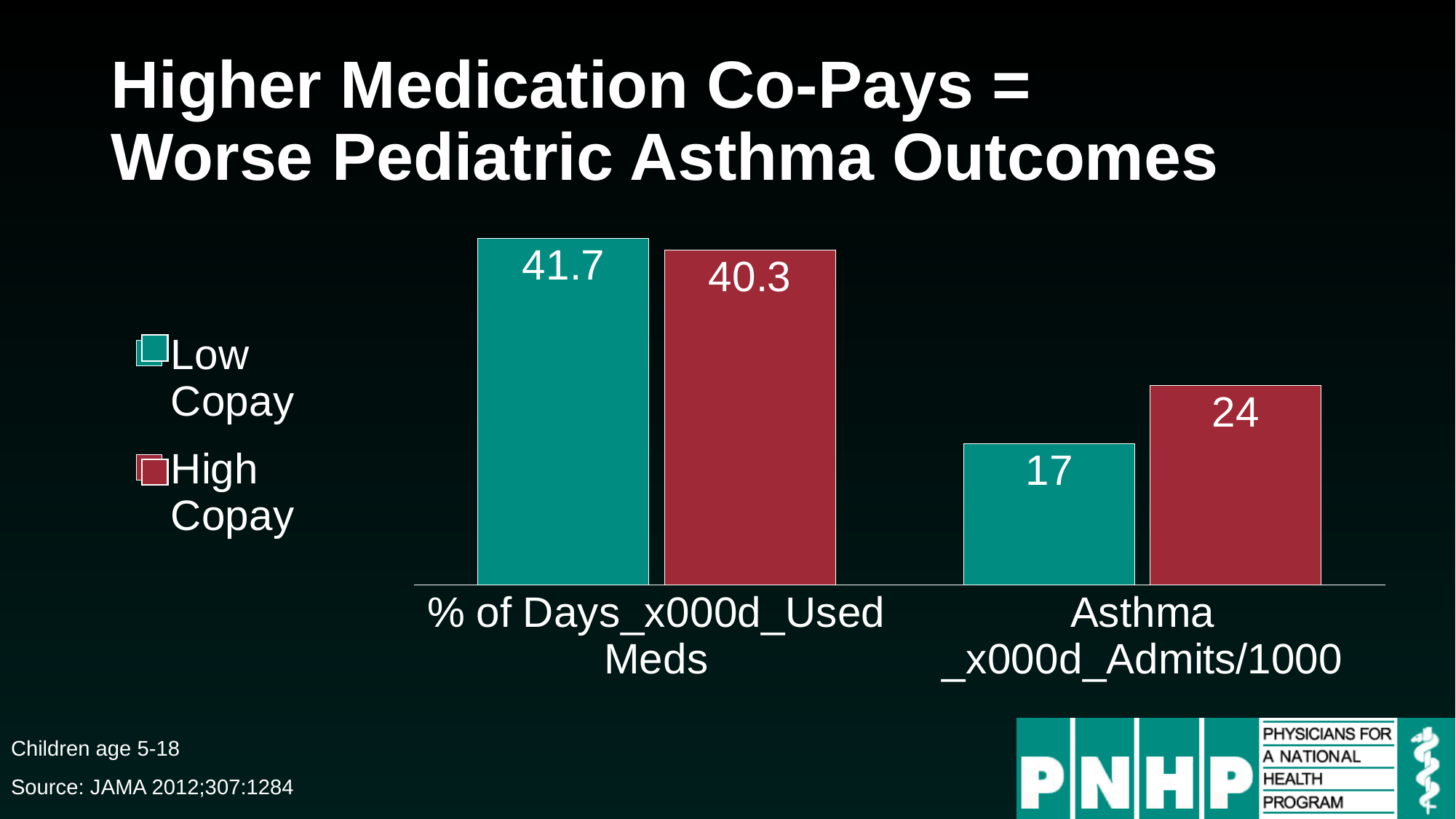
What is the Low Copay value for Asthma Admits/1000? 17 What is the Low Copay value for % of Days Used Meds? 41.7 What is the difference between the Low Copay and High Copay values for % of Days Used Meds? 1.4 What is the High Copay value for Asthma Admits/1000? 24 What is the difference between the High Copay and Low Copay values for Asthma Admits/1000? 7 For Asthma Admits/1000, which group has the larger value, Low Copay or High Copay? High Copay Which bar has the lowest value on the chart? Low Copay, Asthma Admits/1000 For % of Days Used Meds, which group has the larger value, Low Copay or High Copay? Low Copay What kind of chart is shown on the slide? Bar chart How many categories are shown on the x axis? 2 What is the High Copay value for % of Days Used Meds? 40.3 How many series does the legend list? 2